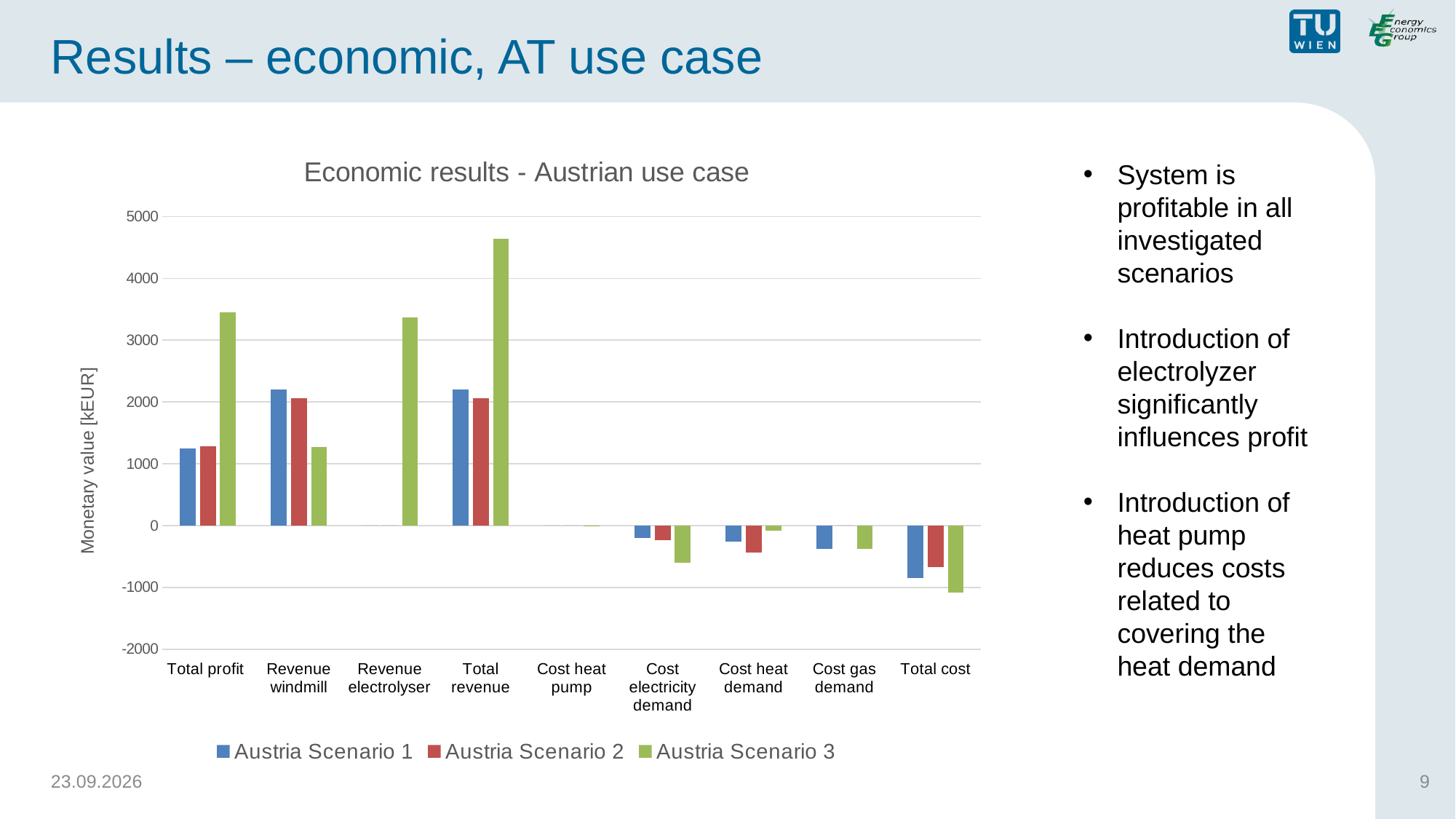
What is the title of the chart? Economic results - Austrian use case How many series does the legend list? 3 For Revenue windmill, which is larger: Austria Scenario 1 or Austria Scenario 3? Austria Scenario 1 Is the Total revenue value for Austria Scenario 3 greater or less than 4000? greater What is the label of the vertical axis? Monetary value [kEUR] Is the Total cost value for Austria Scenario 3 greater or less than -1000? less For Austria Scenario 3, which category has the highest value? Total revenue What kind of chart is shown on the slide? bar chart How many categories are shown on the x axis? 9 Is the Total profit value for Austria Scenario 3 greater or less than 3000? greater For Total profit, which is larger: Austria Scenario 1 or Austria Scenario 3? Austria Scenario 3 For Austria Scenario 3, which category has the lowest value? Total cost